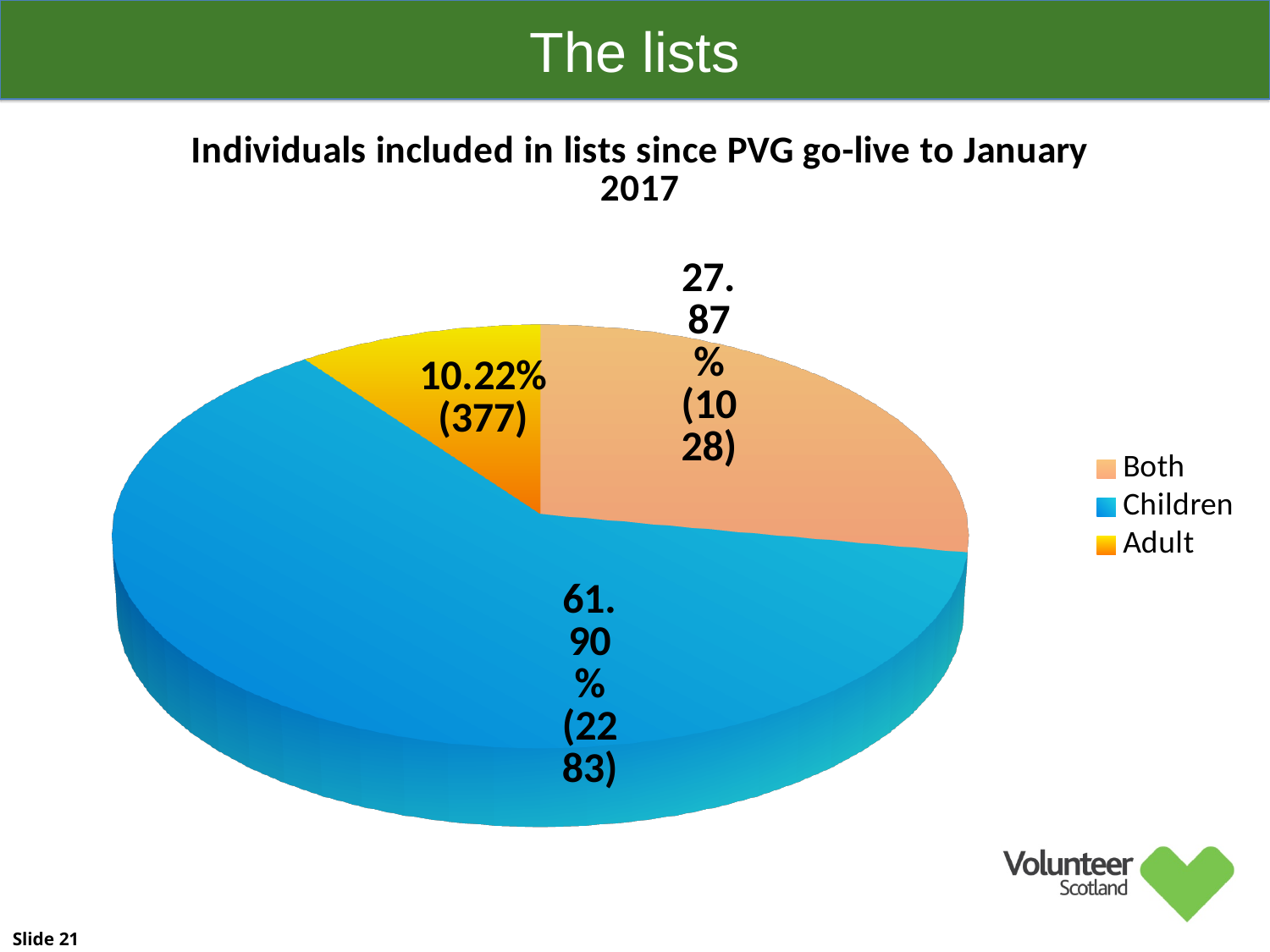
What kind of chart is shown on the slide? Pie chart How many individuals are in the Adult list? 377 What percentage of individuals are in the Children list? 61.90% What percentage of individuals are in the Both category? 27.87% Which category has the smallest share of the pie? Adult Which category has the largest share of the pie? Children How many individuals are in the Children list? 2283 How many slices does the pie chart have? 3 How many entries does the legend list? 3 What percentage of individuals are in the Adult list? 10.22% What is the title of the chart? Individuals included in lists since PVG go-live to January 2017 How many more individuals are in the Both category than in the Adult list? 651